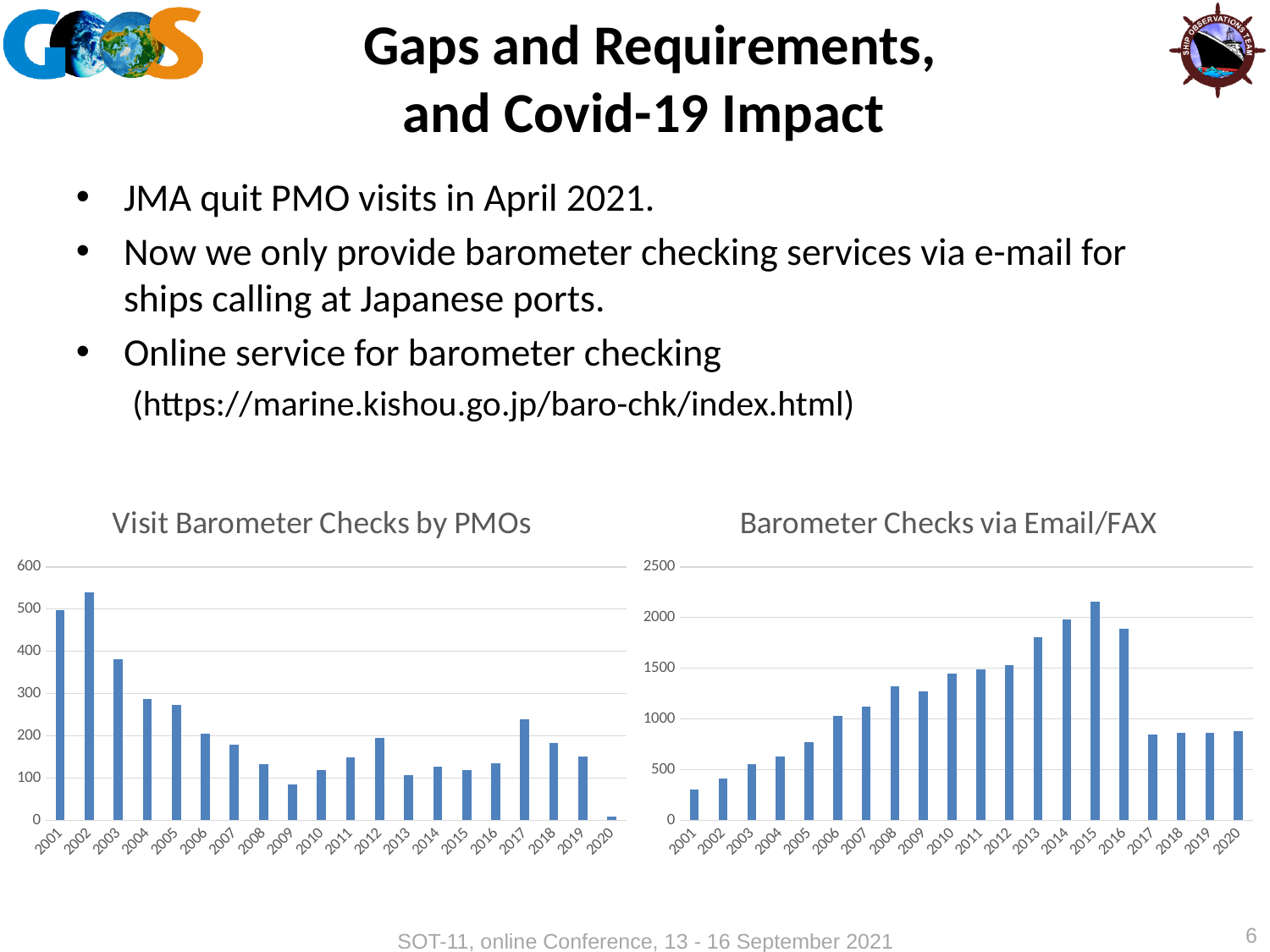
In the 'Visit Barometer Checks by PMOs' chart, is the value for 2003 greater or less than 300? greater In the 'Visit Barometer Checks by PMOs' chart, which year has the lowest value? 2020 In the 'Barometer Checks via Email/FAX' chart, is the value for 2017 greater or less than 1000? less In the 'Barometer Checks via Email/FAX' chart, do the values rise or fall from 2001 to 2015? rise How many years are shown on the x axis of the 'Visit Barometer Checks by PMOs' chart? 20 In the 'Visit Barometer Checks by PMOs' chart, which year has the highest value? 2002 In the 'Barometer Checks via Email/FAX' chart, which year has the highest value? 2015 In the 'Visit Barometer Checks by PMOs' chart, which is larger, the value for 2017 or the value for 2018? 2017 In the 'Visit Barometer Checks by PMOs' chart, is the value for 2009 greater or less than 100? less In the 'Barometer Checks via Email/FAX' chart, which year has the lowest value? 2001 What kind of chart is the 'Barometer Checks via Email/FAX' chart? bar chart